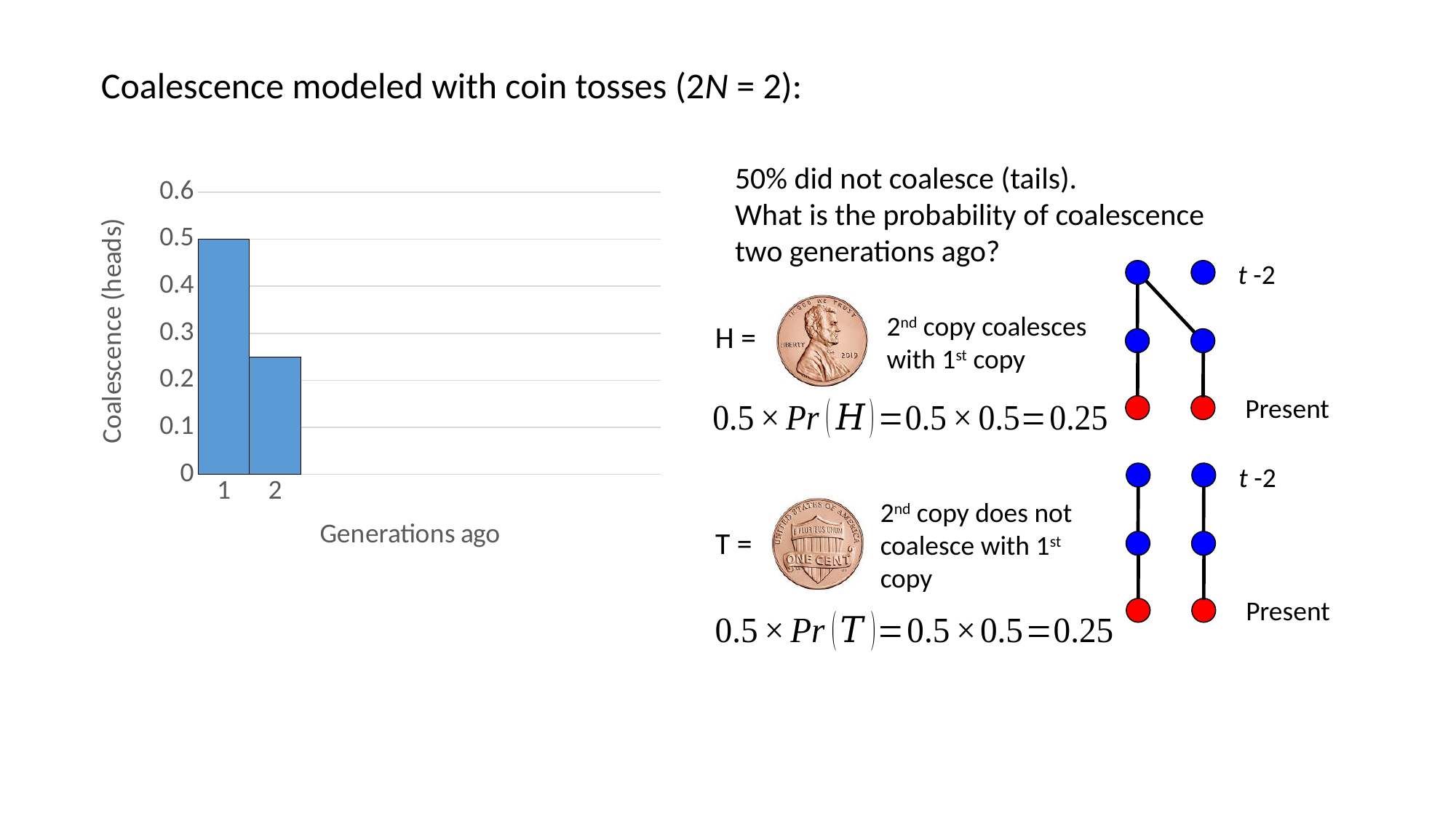
What is the title of the vertical axis of the chart? Coalescence (heads) Is the coalescence value for generation 1 greater or less than 0.4? greater How many categories (generations) are plotted on the x axis of the chart? 2 Which bar is taller in the chart, generation 1 or generation 2? 1 Do the bar values rise or fall from generation 1 to generation 2? fall What is the title of the horizontal axis of the chart? Generations ago What kind of chart is shown on the slide? bar chart What is the coalescence value for generation 1 in the chart? 0.5 Is the coalescence value for generation 2 greater or less than 0.3? less Which generation has the highest coalescence value in the chart? 1 Which generation has the lowest coalescence value in the chart? 2 Is the coalescence value for generation 2 greater or less than 0.2? greater